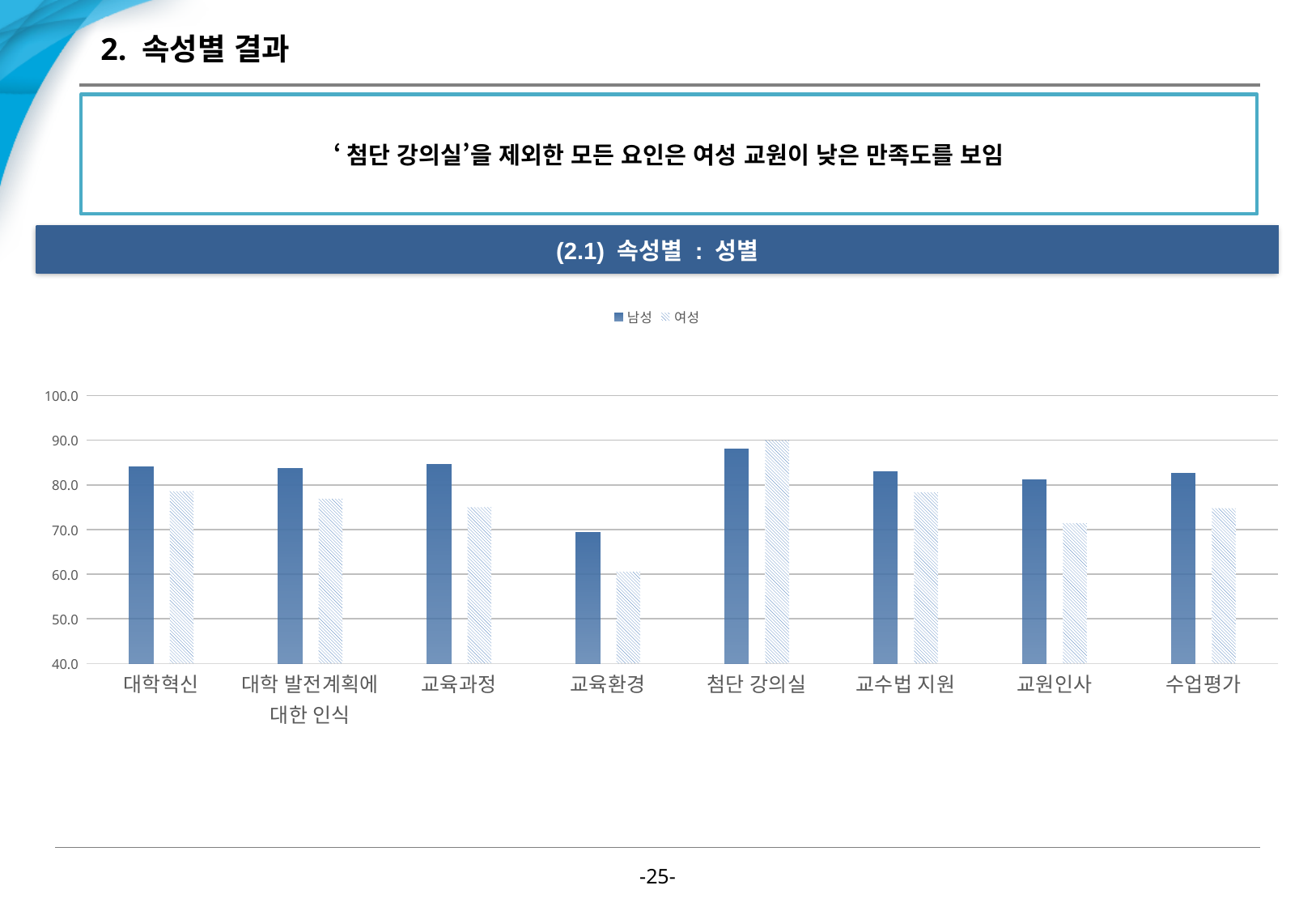
What kind of chart is shown on the slide? bar chart How many categories are shown on the x axis of the chart? 8 Which category has the lowest value for the 여성 series? 교육환경 For 교육환경, which series has the larger value, 남성 or 여성? 남성 Is the 남성 value for 교육환경 greater or less than 80? less Which category has the highest value for the 여성 series? 첨단 강의실 What are the two series named in the chart legend? 남성, 여성 Is the 여성 value for 교원인사 greater or less than 80? less How many series does the chart legend list? 2 Which category has the lowest value for the 남성 series? 교육환경 Which category has the highest value for the 남성 series? 첨단 강의실 Is the 여성 value for 첨단 강의실 greater or less than 80? greater